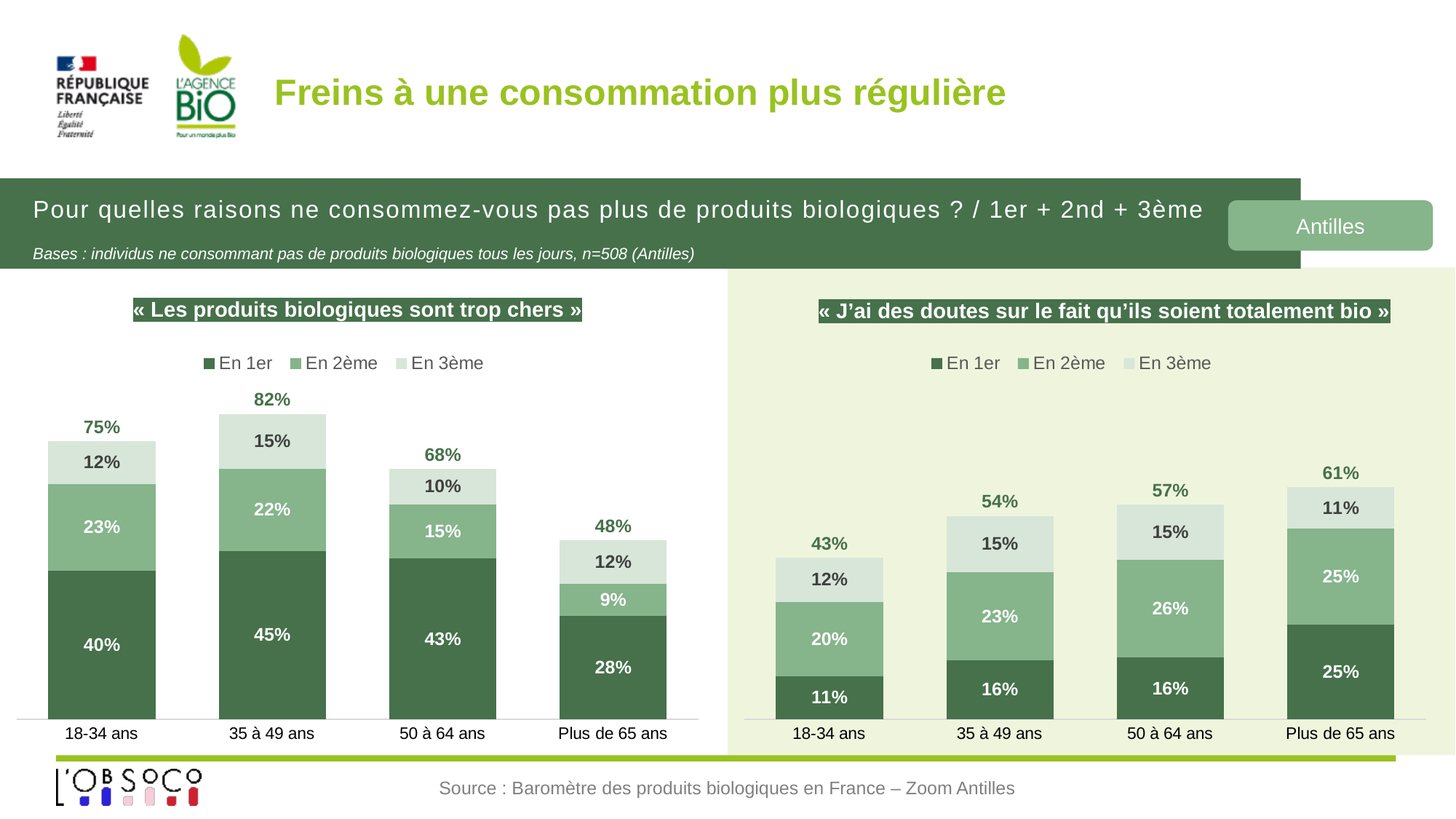
How many age groups are shown in the chart « J'ai des doutes sur le fait qu'ils soient totalement bio »? 4 In the chart « Les produits biologiques sont trop chers », what is the difference between the 'En 1er' values for 18-34 ans and Plus de 65 ans? 12 points In the chart « J'ai des doutes sur le fait qu'ils soient totalement bio », what is the total for Plus de 65 ans? 61% In the chart « J'ai des doutes sur le fait qu'ils soient totalement bio », which age group has the lowest total? 18-34 ans In the chart « J'ai des doutes sur le fait qu'ils soient totalement bio », what is the 'En 2ème' value for 50 à 64 ans? 26% How many series does the legend list in the chart « Les produits biologiques sont trop chers »? 3 What kind of chart is « Les produits biologiques sont trop chers »? Stacked bar chart In the chart « J'ai des doutes sur le fait qu'ils soient totalement bio », do the totals rise or fall from 18-34 ans to Plus de 65 ans? Rise In the chart « Les produits biologiques sont trop chers », what is the 'En 1er' value for 35 à 49 ans? 45% In the chart « Les produits biologiques sont trop chers », which age group has the highest total? 35 à 49 ans In the chart « Les produits biologiques sont trop chers », what is the total shown above the bar for Plus de 65 ans? 48% In the chart « J'ai des doutes sur le fait qu'ils soient totalement bio », is the 'En 1er' value larger for 18-34 ans or for Plus de 65 ans? Plus de 65 ans